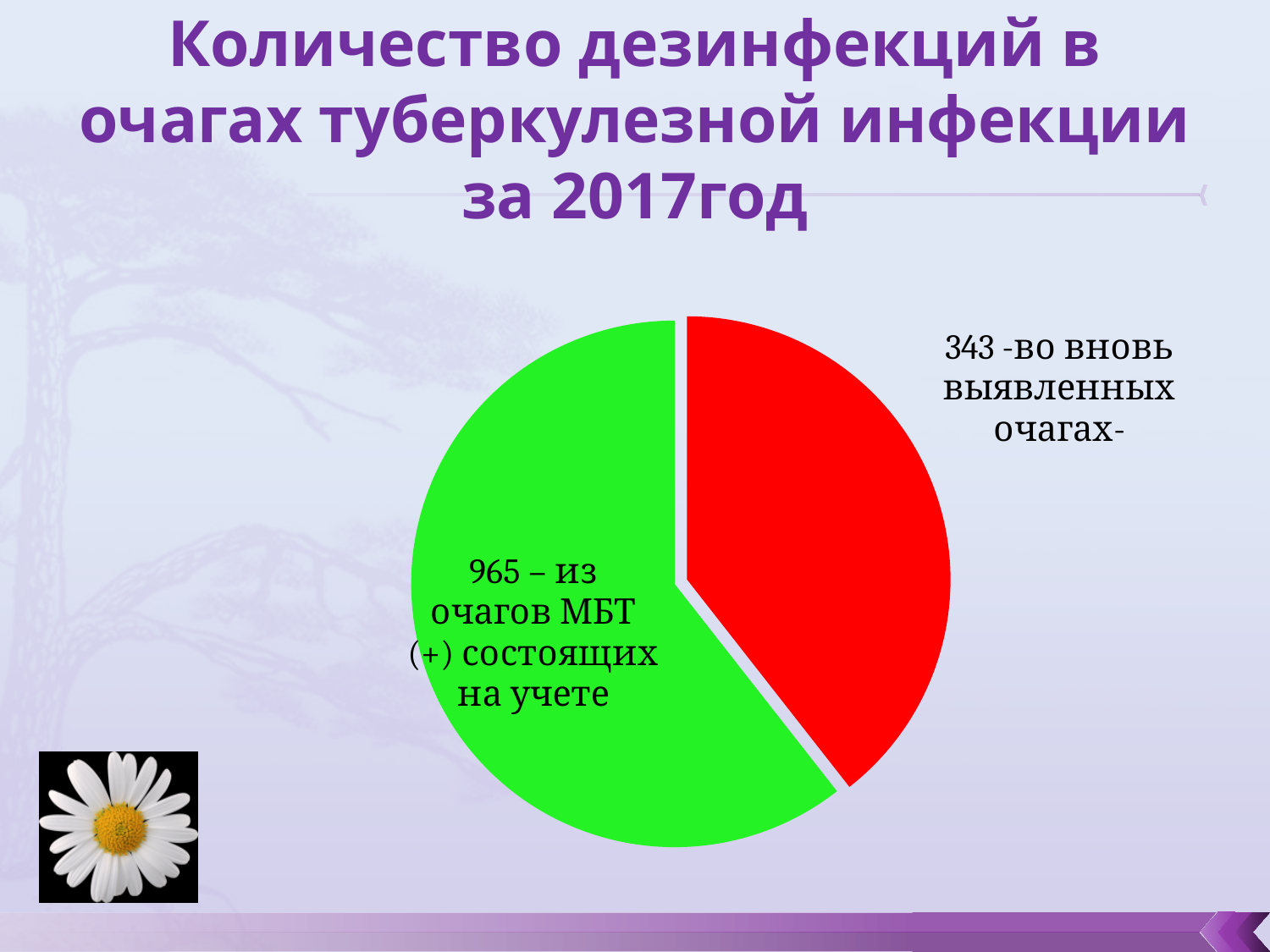
Which category has the larger slice of the pie? 965 – из очагов МБТ (+) состоящих на учете Which is larger: the number of disinfections in registered MBT(+) foci or in newly identified foci? Registered MBT(+) foci (965) What is the difference between the number of disinfections in registered MBT(+) foci and in newly identified foci? 622 What is the total number of disinfections shown in the pie chart? 1308 What is the number of disinfections in registered MBT(+) foci (из очагов МБТ (+) состоящих на учете)? 965 What is the number of disinfections in newly identified foci (во вновь выявленных очагах)? 343 Which category has the smaller slice of the pie? 343 – во вновь выявленных очагах What kind of chart is shown on the slide? Pie chart What year does the chart title refer to? 2017 How many slices does the pie chart have? 2 What colour is the slice for newly identified foci (во вновь выявленных очагах)? Red